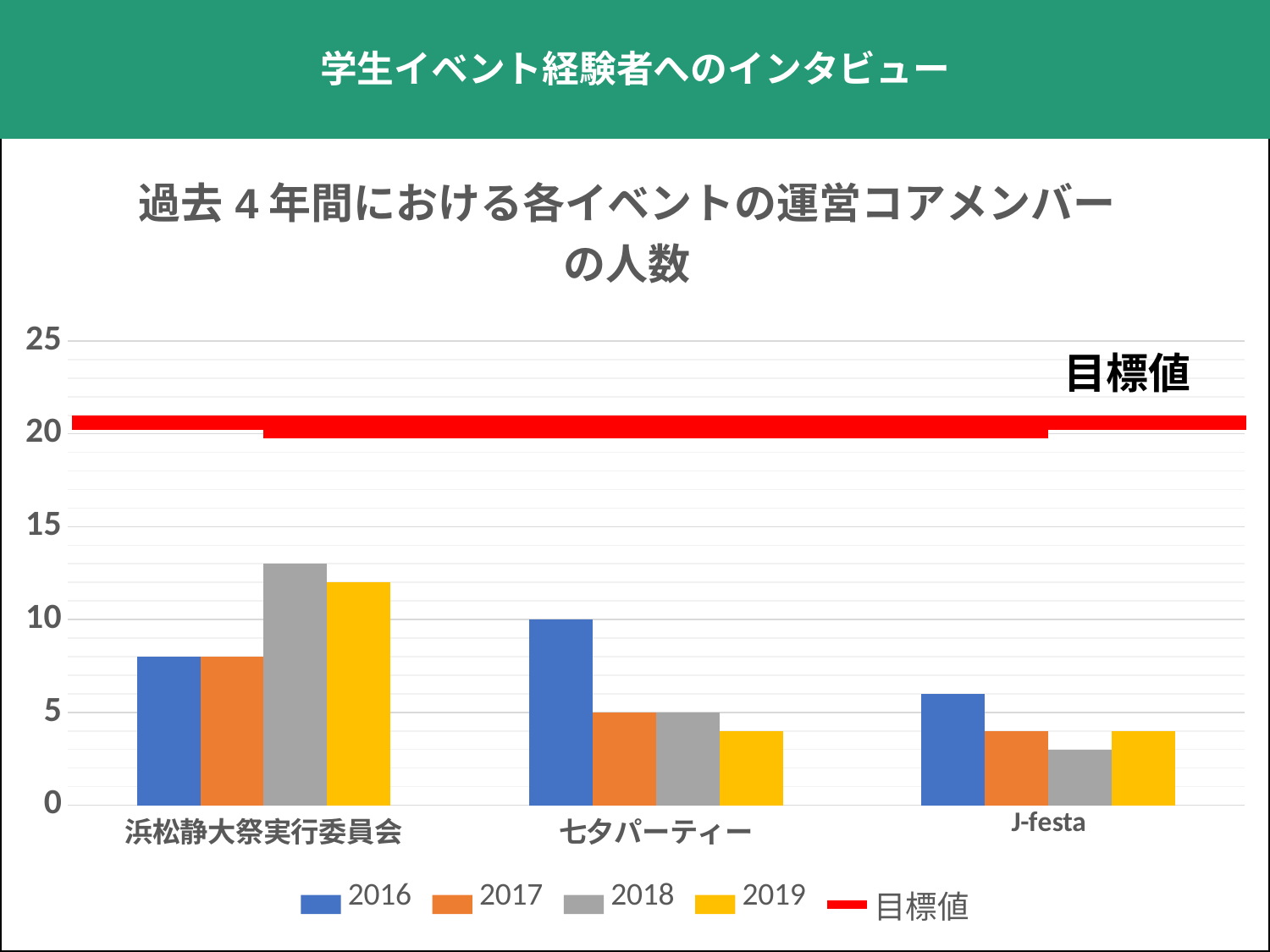
Which event has the highest bar in 2018? 浜松静大祭実行委員会 Is the value for 浜松静大祭実行委員会 in 2018 greater or less than 10? greater What kind of chart is shown on the slide? combination bar and line chart How many event categories are shown on the x axis? 3 What is the title of the chart? 過去４年間における各イベントの運営コアメンバーの人数 What is the value for 七夕パーティー in 2017? 5 Which event has the lowest bar in 2018? J-festa Is the value for J-festa in 2018 greater or less than 5? less What is the value for 七夕パーティー in 2016? 10 Is the value for 浜松静大祭実行委員会 in 2016 greater or less than 10? less Which is larger: the 2019 value for 浜松静大祭実行委員会 or the 2016 value for 七夕パーティー? 2019 value for 浜松静大祭実行委員会 How many entries does the legend list? 5